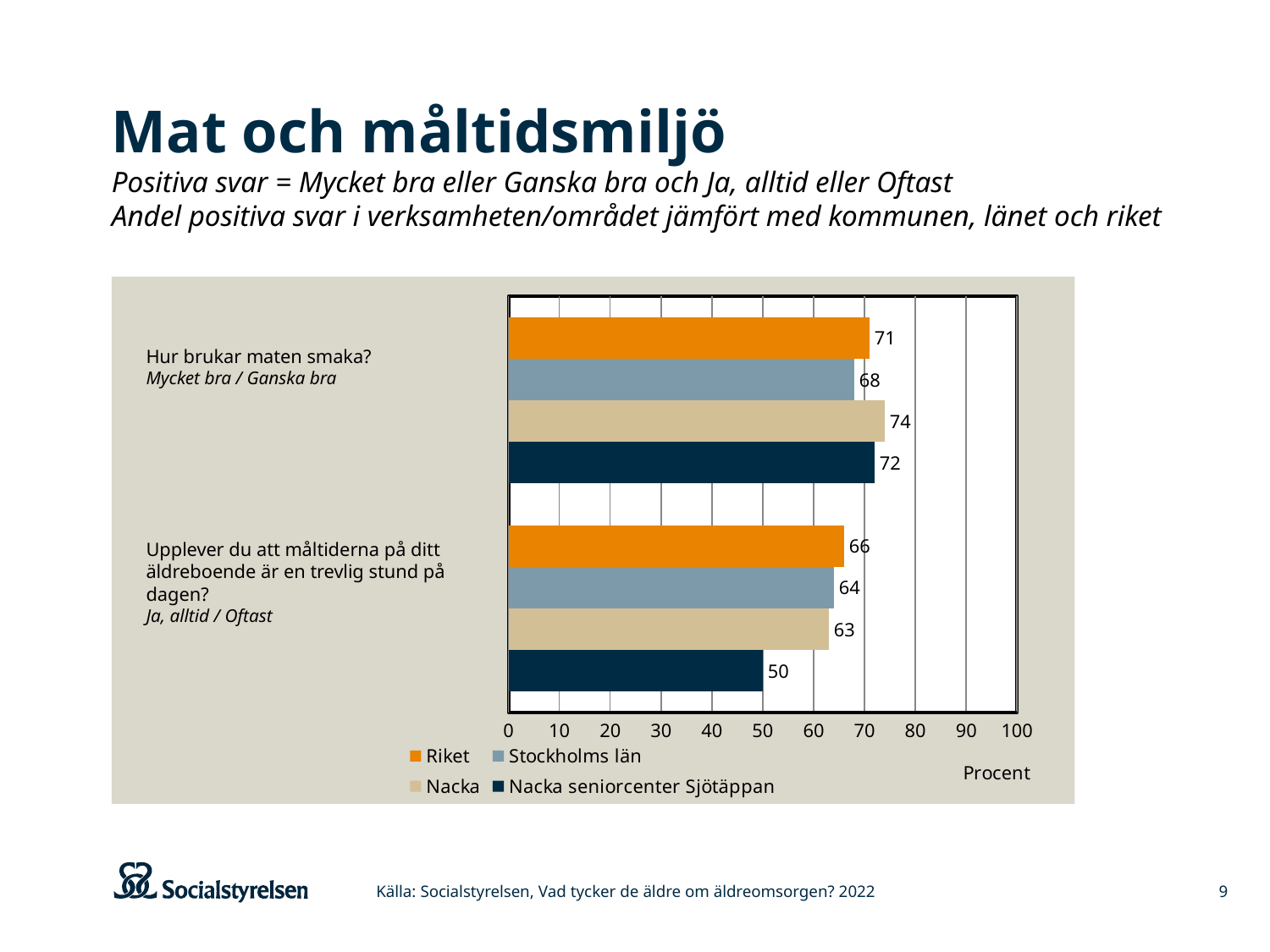
How many series does the legend list? 4 Which series has the lowest value for "Upplever du att måltiderna på ditt äldreboende är en trevlig stund på dagen?"? Nacka seniorcenter Sjötäppan What is the value for Stockholms län for "Hur brukar maten smaka?"? 68 What kind of chart is shown on the slide? Bar chart What is the difference between the Nacka seniorcenter Sjötäppan values for the two questions? 22 What is the difference between Nacka and Stockholms län for "Hur brukar maten smaka?"? 6 What is the value for Nacka for "Upplever du att måltiderna på ditt äldreboende är en trevlig stund på dagen?"? 63 Which is larger for "Upplever du att måltiderna på ditt äldreboende är en trevlig stund på dagen?": Riket or Nacka seniorcenter Sjötäppan? Riket Which series has the highest value for "Hur brukar maten smaka?"? Nacka What is the value for Riket for "Hur brukar maten smaka?"? 71 What is the label on the horizontal axis of the chart? Procent What is the value for Nacka seniorcenter Sjötäppan for "Upplever du att måltiderna på ditt äldreboende är en trevlig stund på dagen?"? 50